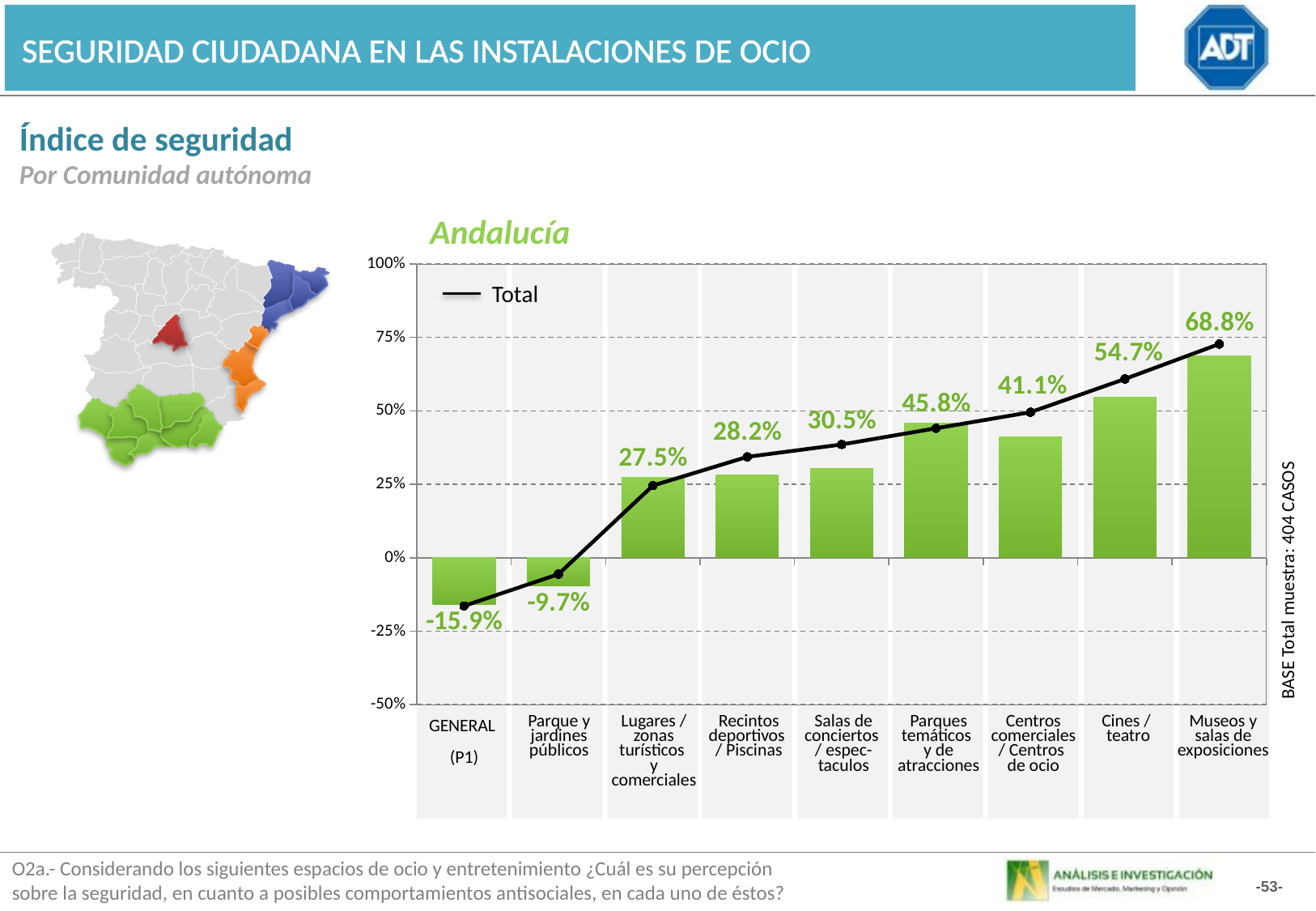
Which category has the highest value in the Andalucía chart? Museos y salas de exposiciones How many categories are shown on the x axis of the Andalucía chart? 9 What is the value for Parques temáticos y de atracciones? 45.8% What is the name of the series shown in the legend? Total What kind of chart is used for the Andalucía data? Bar chart with a line Which is larger, the value for Parques temáticos y de atracciones or for Centros comerciales / Centros de ocio? Parques temáticos y de atracciones What is the value for Museos y salas de exposiciones in the Andalucía chart? 68.8% What is the value for GENERAL (P1) in the Andalucía chart? -15.9% What is the value for Cines / teatro? 54.7% Which category has the lowest value in the Andalucía chart? GENERAL (P1) What is the difference between the values for Museos y salas de exposiciones and Cines / teatro? 14.1% How many series does the legend list? 1